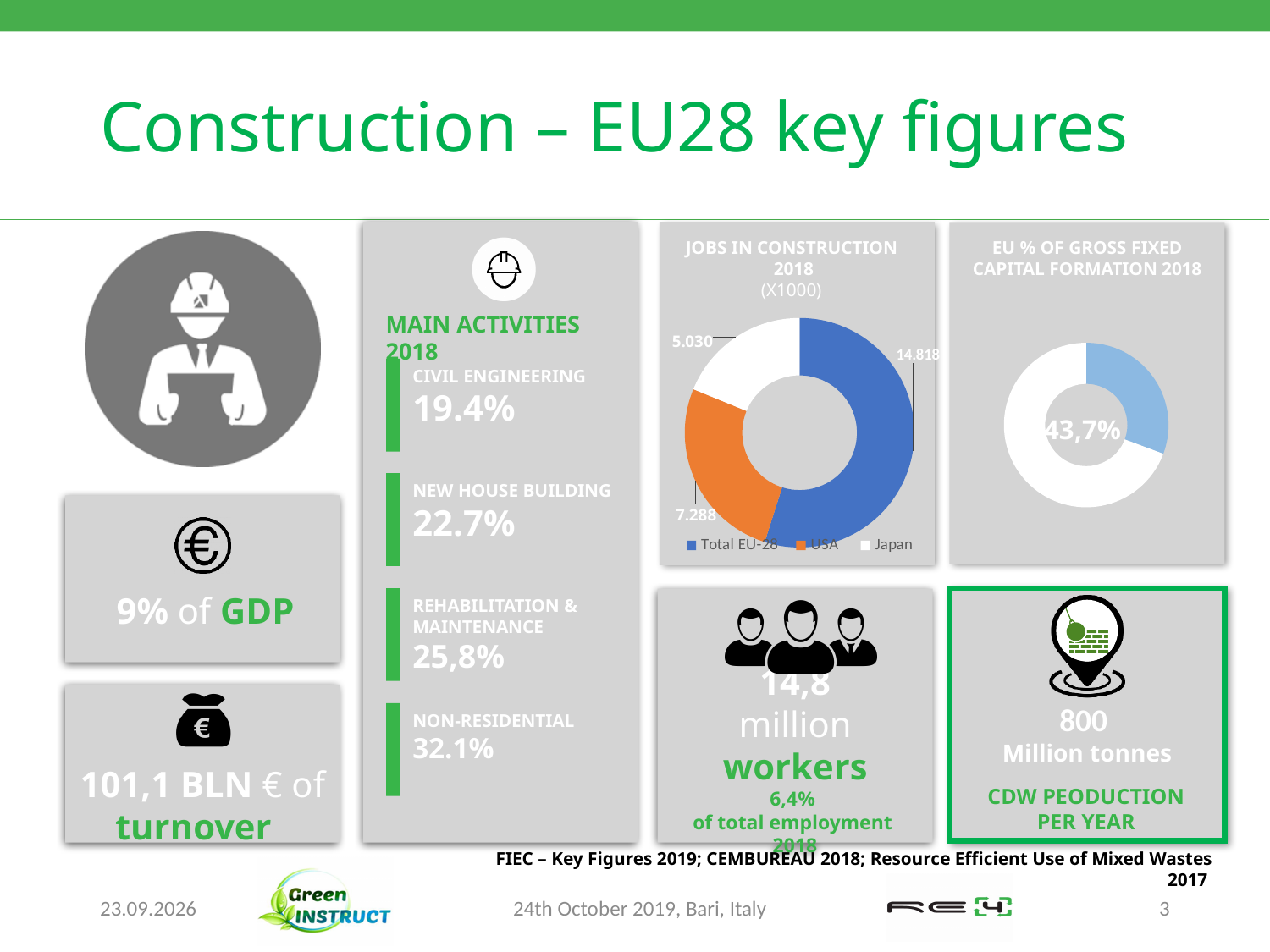
In the 'EU % of Gross Fixed Capital Formation 2018' chart, what percentage is shown? 43,7% In the 'Jobs in Construction 2018' chart, which category has the highest value? Total EU-28 What kind of chart is the 'Jobs in Construction 2018' chart? Doughnut chart In the 'Jobs in Construction 2018' chart, which is larger, the value for USA or the value for Japan? USA In the 'Jobs in Construction 2018' chart, what is the value for Japan? 5.030 In the 'Jobs in Construction 2018' chart, what is the value for USA? 7.288 In the 'Jobs in Construction 2018' chart, what unit is indicated under the title? (X1000) In the 'Jobs in Construction 2018' chart, what is the difference between the Total EU-28 value and the USA value? 7.530 How many categories does the 'Jobs in Construction 2018' chart show? 3 In the 'Jobs in Construction 2018' chart, what is the value for Total EU-28? 14.818 In the 'Jobs in Construction 2018' chart, which category has the lowest value? Japan How many entries does the legend of the 'Jobs in Construction 2018' chart list? 3